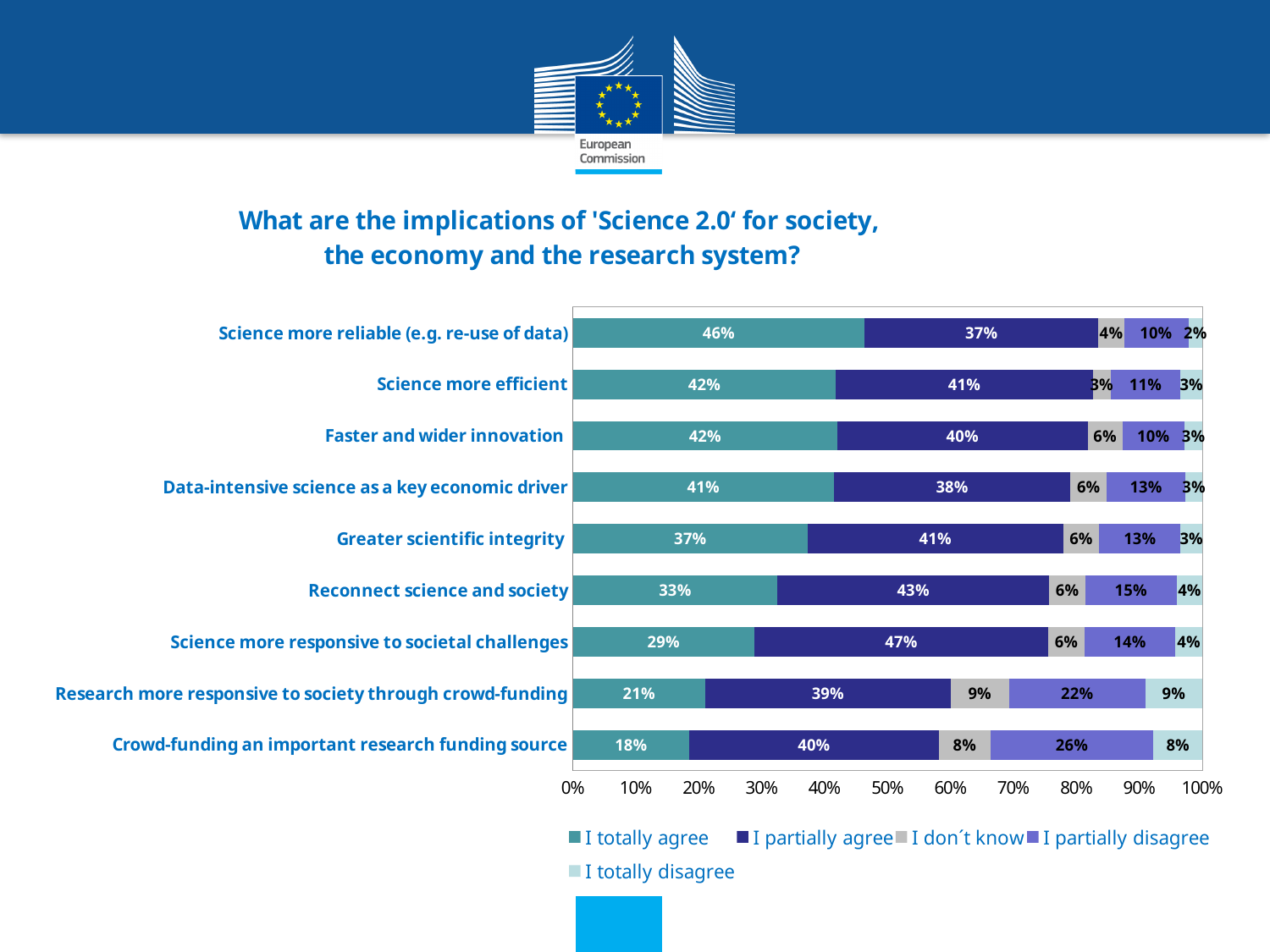
Which legend entry is represented by the grey segments in the bars? I don't know What is the combined share of 'I totally agree' and 'I partially agree' for 'Faster and wider innovation'? 82% What is the 'I partially disagree' value for 'Crowd-funding an important research funding source'? 26% Which category has the lowest 'I totally agree' share? Crowd-funding an important research funding source What kind of chart is shown on the slide? Stacked bar chart How many series does the legend list? 5 What percentage of respondents totally agree that Science 2.0 makes science more reliable (e.g. re-use of data)? 46% Which has a larger 'I partially disagree' value: 'Research more responsive to society through crowd-funding' or 'Reconnect science and society'? Research more responsive to society through crowd-funding What is the difference between the 'I totally agree' values for 'Science more reliable (e.g. re-use of data)' and 'Greater scientific integrity'? 9% What is the 'I partially agree' value for 'Science more responsive to societal challenges'? 47% How many categories (statements) are shown in the chart? 9 Which category has the highest 'I totally agree' share? Science more reliable (e.g. re-use of data)